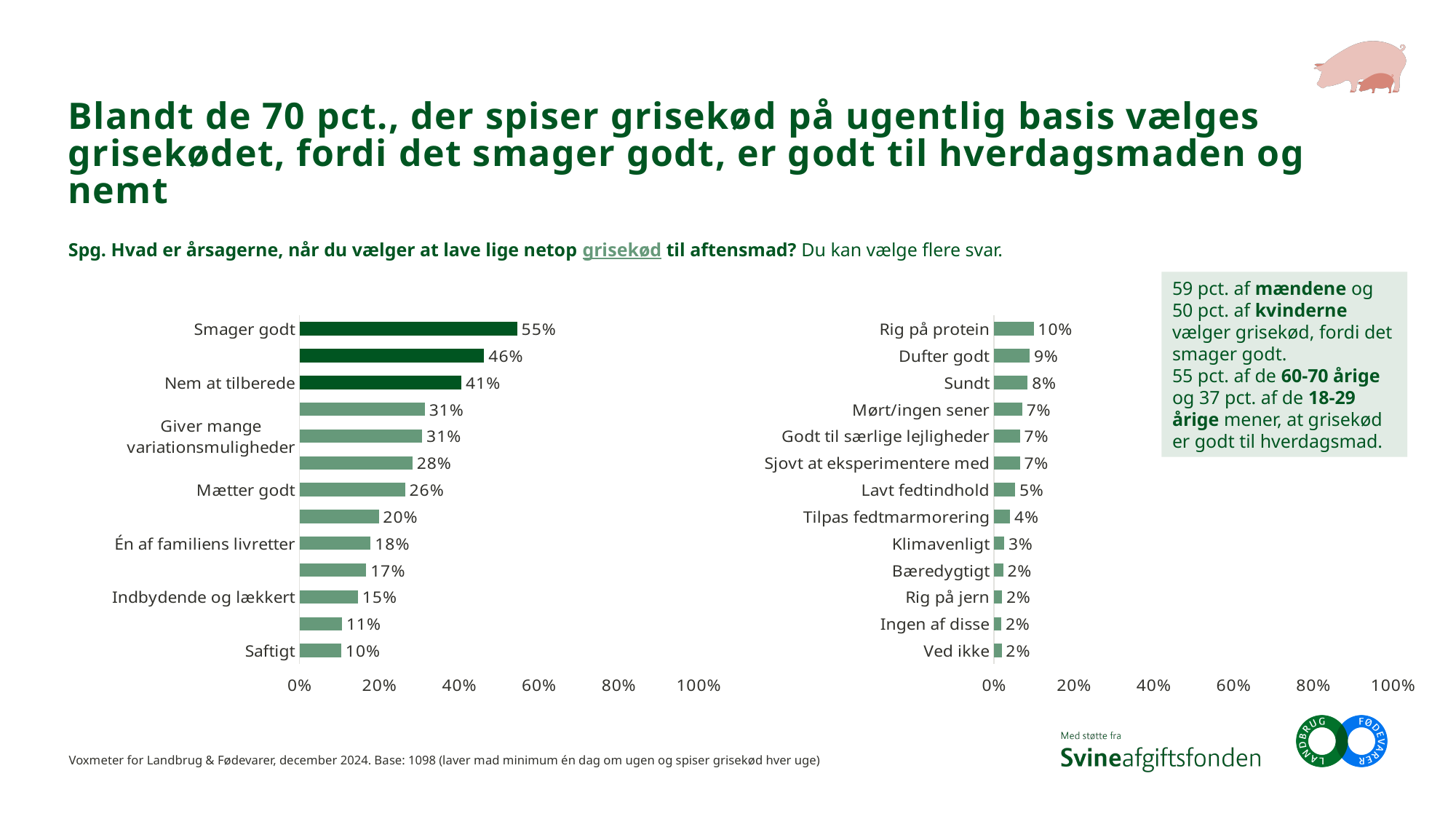
What type of chart is used on the slide? Bar chart In the right chart, what is the value for "Lavt fedtindhold"? 5% In the left chart, which category has the lowest value? Saftigt In the left chart, what is the value for "Nem at tilberede"? 41% In the left chart, is the value for "Mætter godt" greater or less than 20%? greater In the right chart, which category has the highest value? Rig på protein In the right chart, what is the value for "Rig på protein"? 10% In the left chart, what is the value for "Smager godt"? 55% How many bars does the right chart have? 13 In the left chart, what is the difference between "Smager godt" and "Nem at tilberede"? 14% In the right chart, which is larger: "Dufter godt" or "Sundt"? Dufter godt In the left chart, which category has the highest value? Smager godt